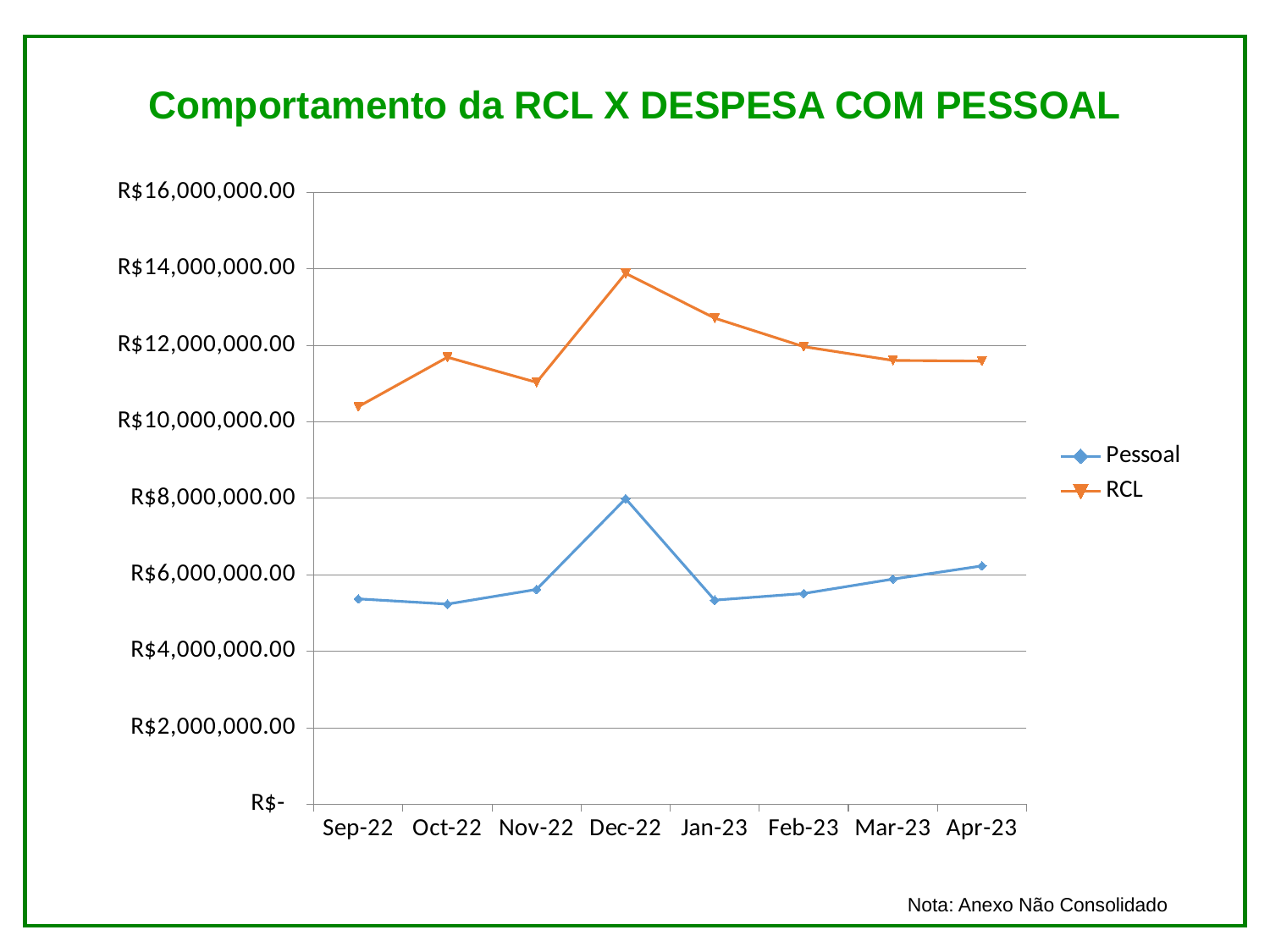
What is the title of the chart? Comportamento da RCL X DESPESA COM PESSOAL In which month is the RCL series at its lowest value? Sep-22 Is the RCL value for Dec-22 greater or less than R$12,000,000.00? greater What kind of chart is shown on the slide? Line chart Does the RCL series rise or fall from Dec-22 to Apr-23? Fall Which series has the larger value in Feb-23, Pessoal or RCL? RCL In which month does the RCL series reach its highest value? Dec-22 Is the RCL value for Apr-23 greater or less than R$12,000,000.00? less How many series does the legend list? 2 Is the Pessoal value for Dec-22 greater or less than R$6,000,000.00? greater How many months are plotted along the x axis? 8 In which month does the Pessoal series reach its highest value? Dec-22